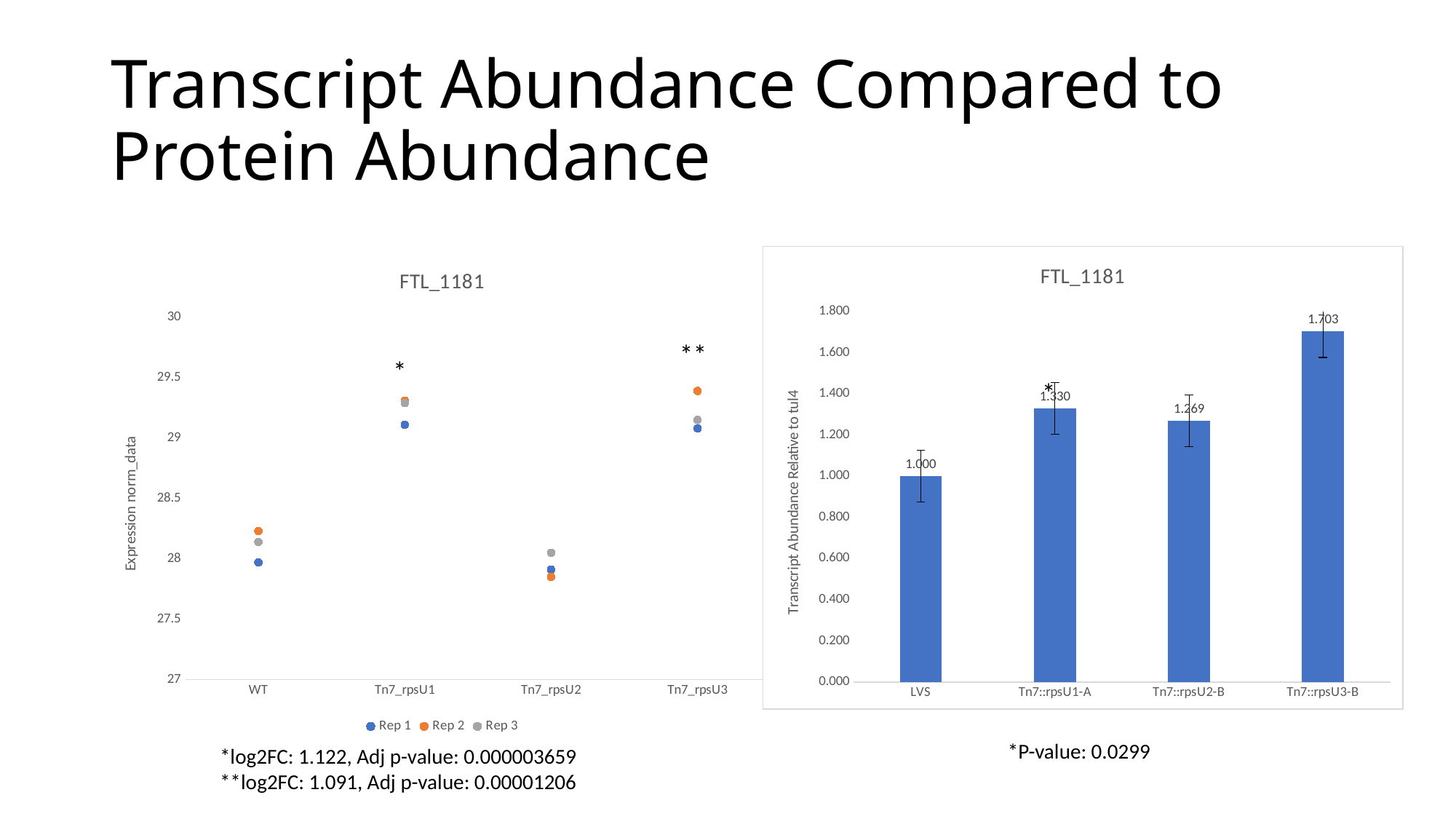
In the bar chart on the right, which category has the lowest transcript abundance? LVS In the bar chart on the right, what is the transcript abundance value for Tn7::rpsU3-B? 1.703 What kind of chart is the chart on the right? Bar chart In the scatter chart on the left, is the Rep 1 value for Tn7_rpsU2 greater or less than 28.5? less In the bar chart on the right, what is the difference between the values for Tn7::rpsU3-B and LVS? 0.703 In the bar chart on the right, what is the value for LVS? 1.000 How many series does the legend of the scatter chart on the left list? 3 In the bar chart on the right, which category has the highest transcript abundance? Tn7::rpsU3-B How many categories are shown on the x axis of the bar chart on the right? 4 In the bar chart on the right, what is the value for Tn7::rpsU1-A? 1.330 In the scatter chart on the left, is the Rep 2 value for Tn7_rpsU3 greater or less than 29? greater In the bar chart on the right, which is larger, the value for Tn7::rpsU1-A or Tn7::rpsU2-B? Tn7::rpsU1-A